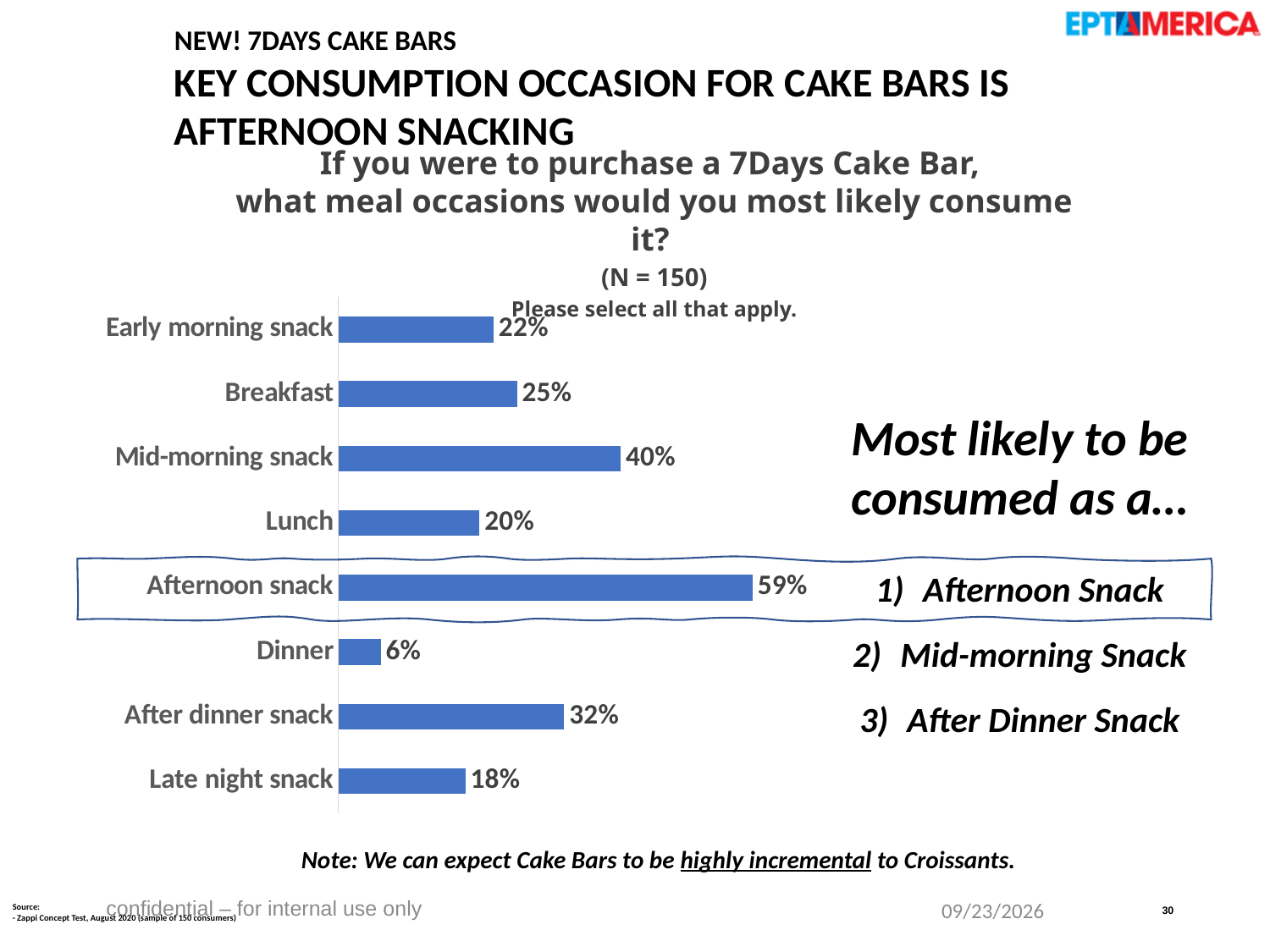
How many meal occasions are shown in the chart? 8 Which is larger, the value for After dinner snack or the value for Lunch? After dinner snack What is the difference between the Breakfast and Early morning snack percentages? 3% What is the value shown for Mid-morning snack? 40% What is the value shown for Late night snack? 18% What is the value shown for Dinner? 6% What percentage of respondents selected Afternoon snack as a consumption occasion? 59% Which meal occasion has the lowest percentage? Dinner What type of chart is used on this slide? Bar chart What is the sample size (N) stated in the chart title? 150 Which meal occasion has the highest percentage? Afternoon snack What is the difference between the Afternoon snack and Mid-morning snack percentages? 19%